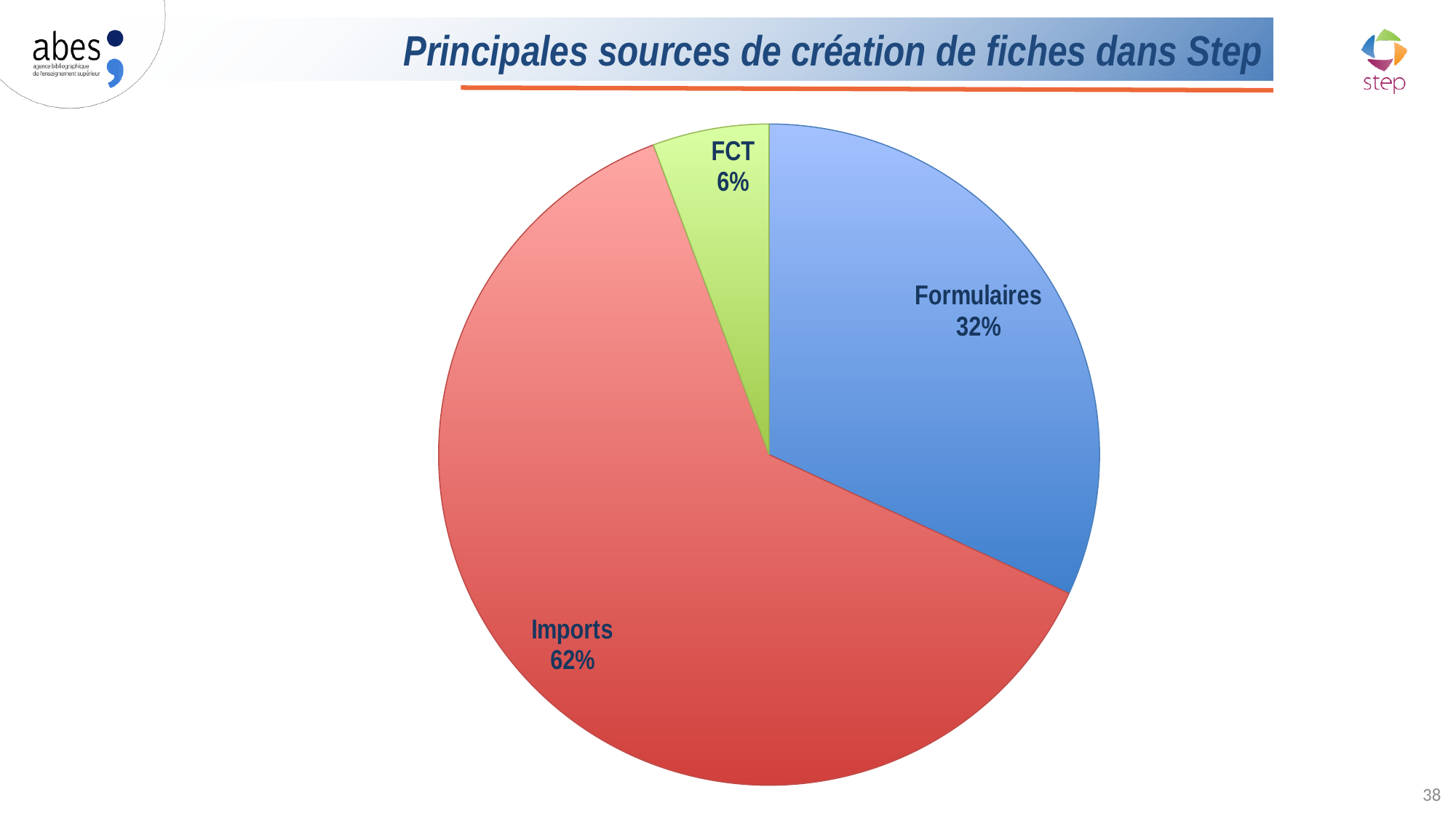
What is the title of the chart? Principales sources de création de fiches dans Step Which category has the smallest slice of the pie? FCT What kind of chart is shown on the slide? pie chart What share of the pie does FCT represent? 6% What share of the pie does Imports represent? 62% What colour is the Imports slice? red What is the difference in percentage points between Imports and Formulaires? 30 What share of the pie does Formulaires represent? 32% Which category has the largest slice of the pie? Imports What is the difference in percentage points between Formulaires and FCT? 26 How many slices does the pie chart have? 3 Which is larger, the share for Formulaires or the share for FCT? Formulaires